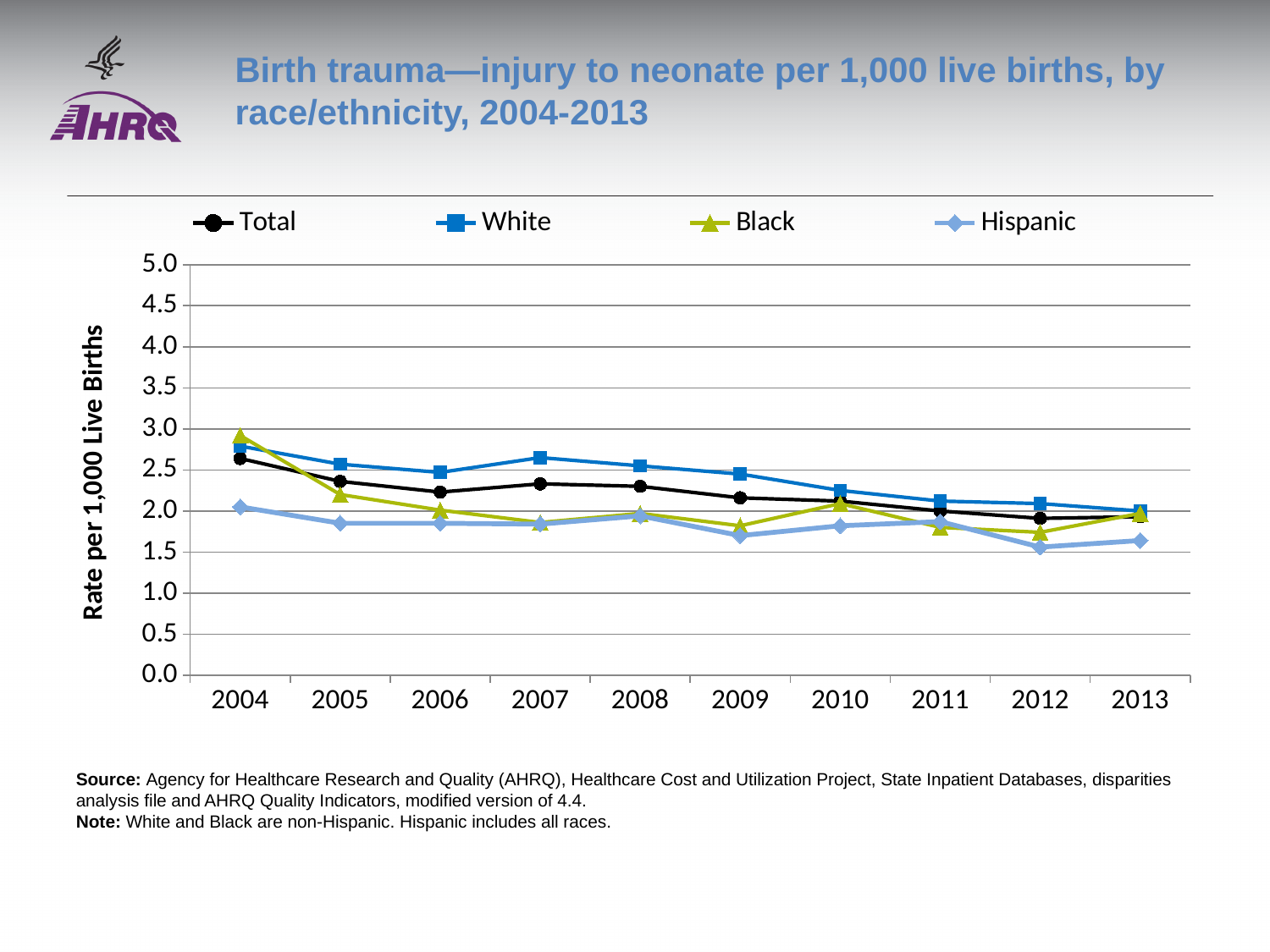
Is the value for White in 2004 greater or less than 2.5? greater Which series has the lowest value in 2004? Hispanic What kind of chart is shown on the slide? line chart How many years are plotted along the x axis? 10 Is the value for Black in 2004 greater or less than 2.5? greater Is the value for Hispanic in 2012 greater or less than 2.0? less In 2004, which is larger, the value for White or the value for Hispanic? White How many series does the legend list? 4 What is the title of the y axis? Rate per 1,000 Live Births In which year is the Hispanic series at its lowest? 2012 Does the White series generally rise or fall from 2004 to 2013? fall In 2012, which is larger, the value for Total or the value for Hispanic? Total